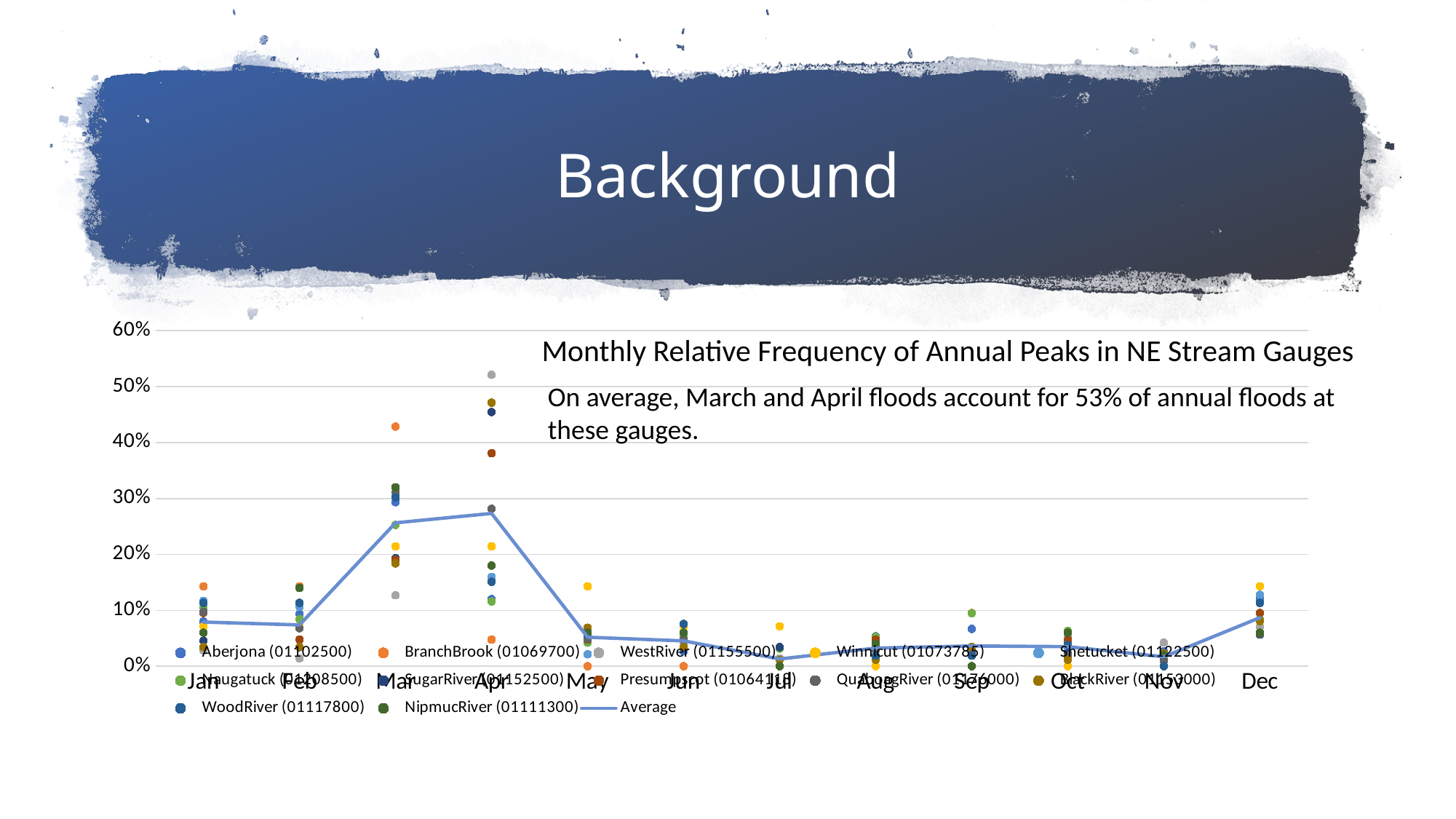
According to the text on the slide, what share of annual floods do March and April floods account for on average? 53% How many entries does the chart's legend list? 13 Does the Average line rise or fall from Nov to Dec? rise What is the title of the chart? Monthly Relative Frequency of Annual Peaks in NE Stream Gauges Is the Average value for Apr greater or less than 20%? greater Is the Average value for Dec greater or less than 10%? less Is the Average value for Mar larger or smaller than the Average value for Jan? larger Is the Average value for Jul greater or less than 10%? less Does the Average line rise or fall from Apr to May? fall How many months are shown along the x axis of the chart? 12